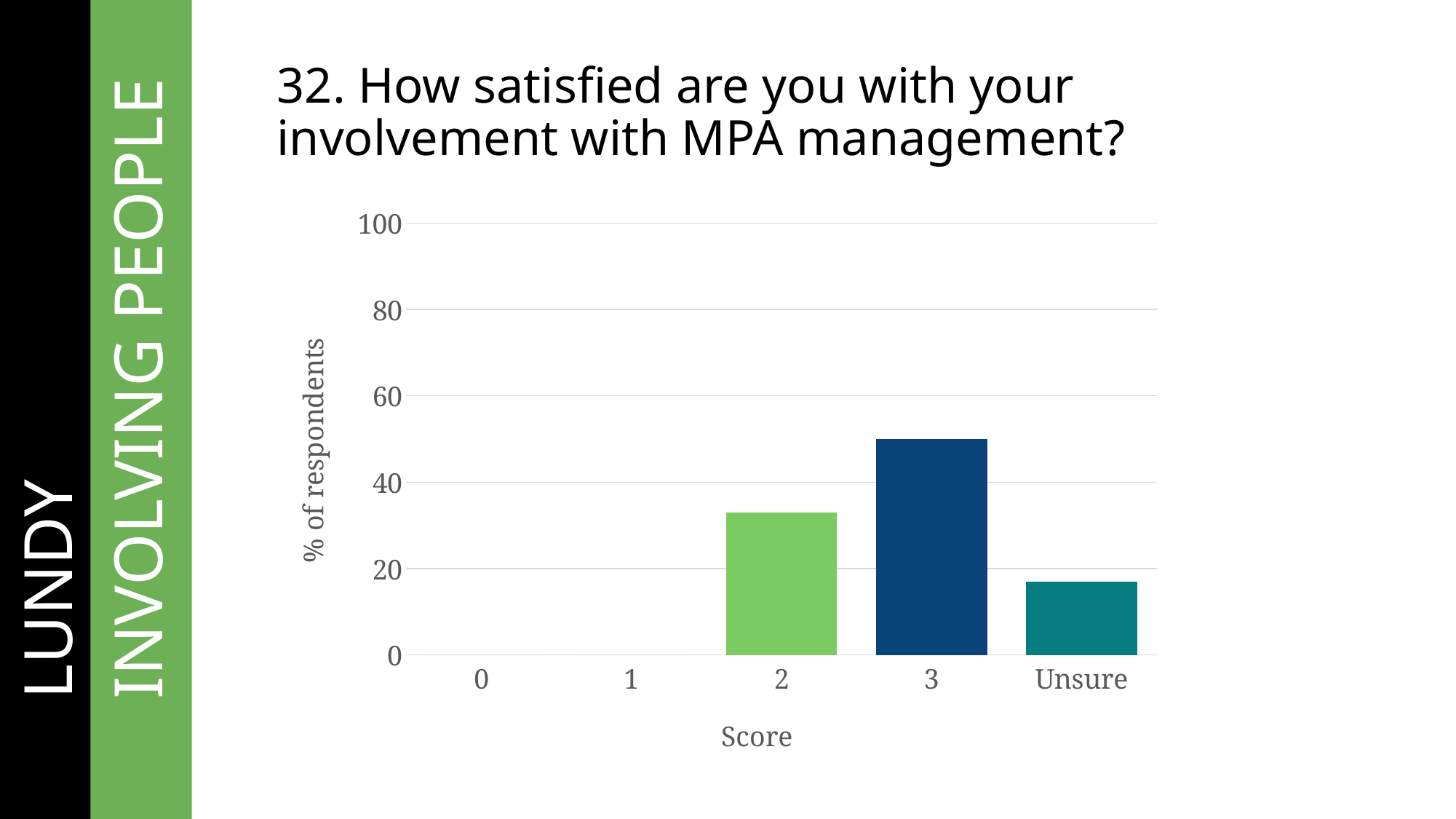
What kind of chart is shown on the slide? bar chart How many score categories are shown on the x axis of the chart? 5 What is the label of the x axis of the chart? Score Which has a higher percentage of respondents, score 3 or score 2? 3 Which has a higher percentage of respondents, score 2 or Unsure? 2 Is the value for score 3 greater or less than 40? greater What is the label of the y axis of the chart? % of respondents Is the value for score 2 greater or less than 20? greater Is the value for score 2 greater or less than 40? less Which score category has the highest percentage of respondents? 3